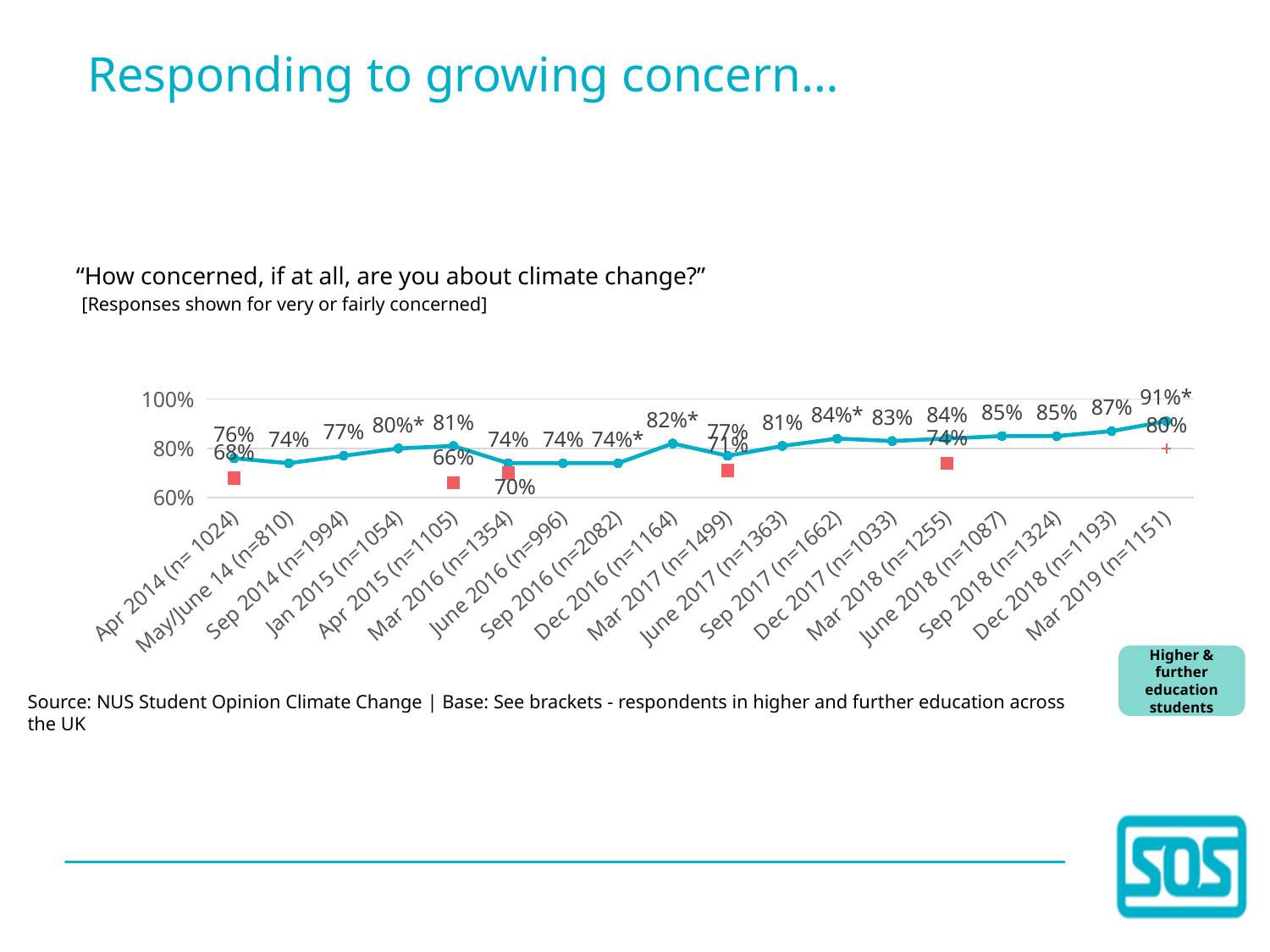
What value is shown for Dec 2016 (n=1164) on the teal line? 82%* What is the difference between the Mar 2019 (n=1151) value and the Apr 2014 (n=1024) value on the teal line? 15 percentage points Which survey wave has the highest value on the teal line? Mar 2019 (n=1151) What type of chart is shown on the slide? line chart Overall, does the teal line rise or fall from Apr 2014 to Mar 2019? rise Is the value for June 2016 (n=996) on the teal line greater or less than 80%? less What survey question is the chart based on? "How concerned, if at all, are you about climate change?" How many survey waves are shown along the x axis? 18 What value is shown for Apr 2014 (n=1024) on the teal line? 76% What percentage of higher and further education students were very or fairly concerned about climate change in Mar 2019 (n=1151)? 91%* What value is shown for Dec 2018 (n=1193) on the teal line? 87%